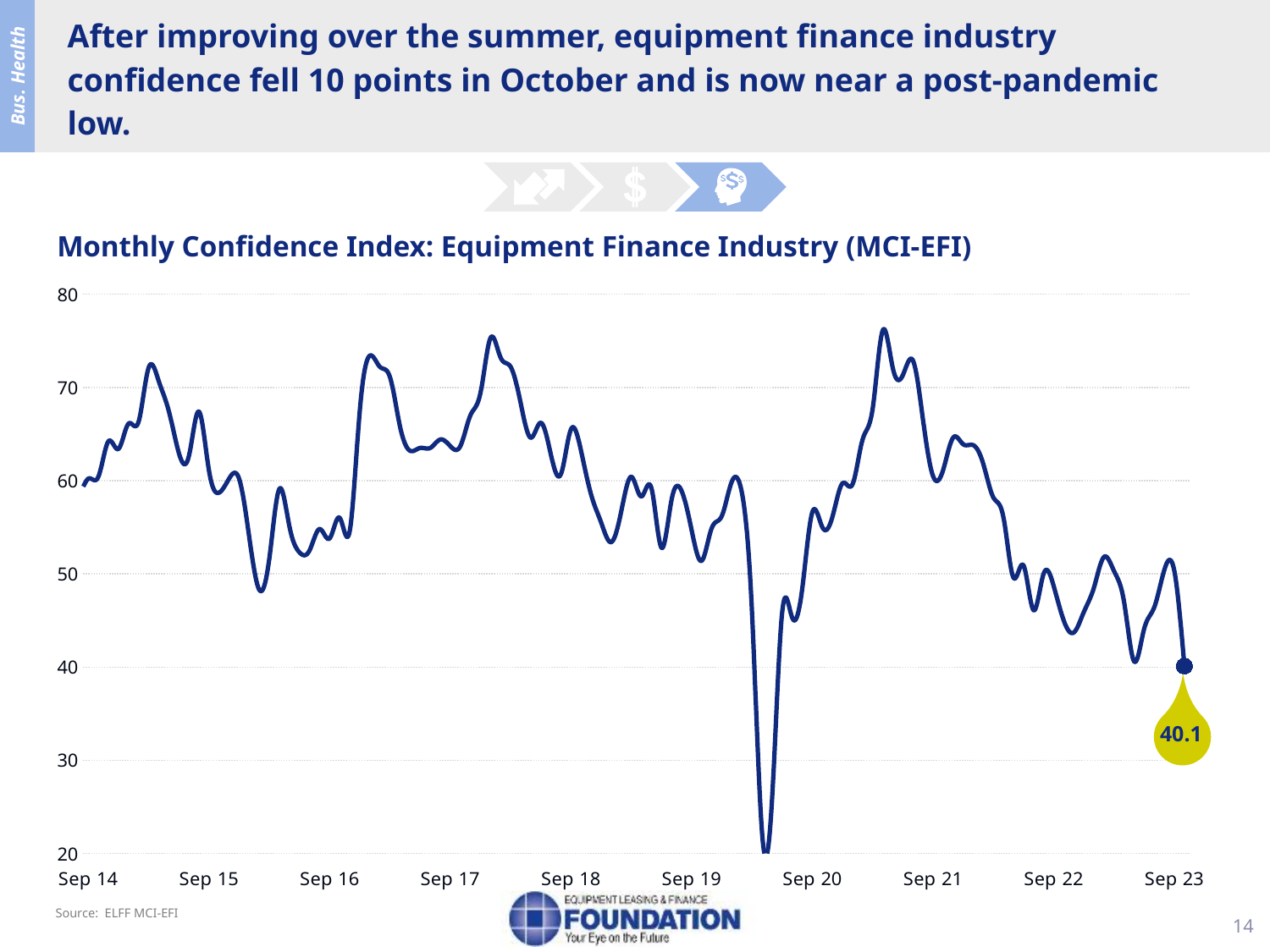
Is the lowest point on the line greater or less than 30? less What is the value of the last data point (Sep 23) on the Monthly Confidence Index chart? 40.1 Which is larger, the value at Sep 14 or the value at Sep 23? Sep 14 What is the title of the chart? Monthly Confidence Index: Equipment Finance Industry (MCI-EFI) How many labelled tick marks are on the x axis? 10 Overall, does the index rise or fall from Sep 14 to Sep 23? fall Which is larger, the value at Sep 21 or the value at Sep 23? Sep 21 Is the value for Sep 17 greater or less than 50? greater What kind of chart is shown on the slide? line chart Is the value for Sep 21 greater or less than 50? greater